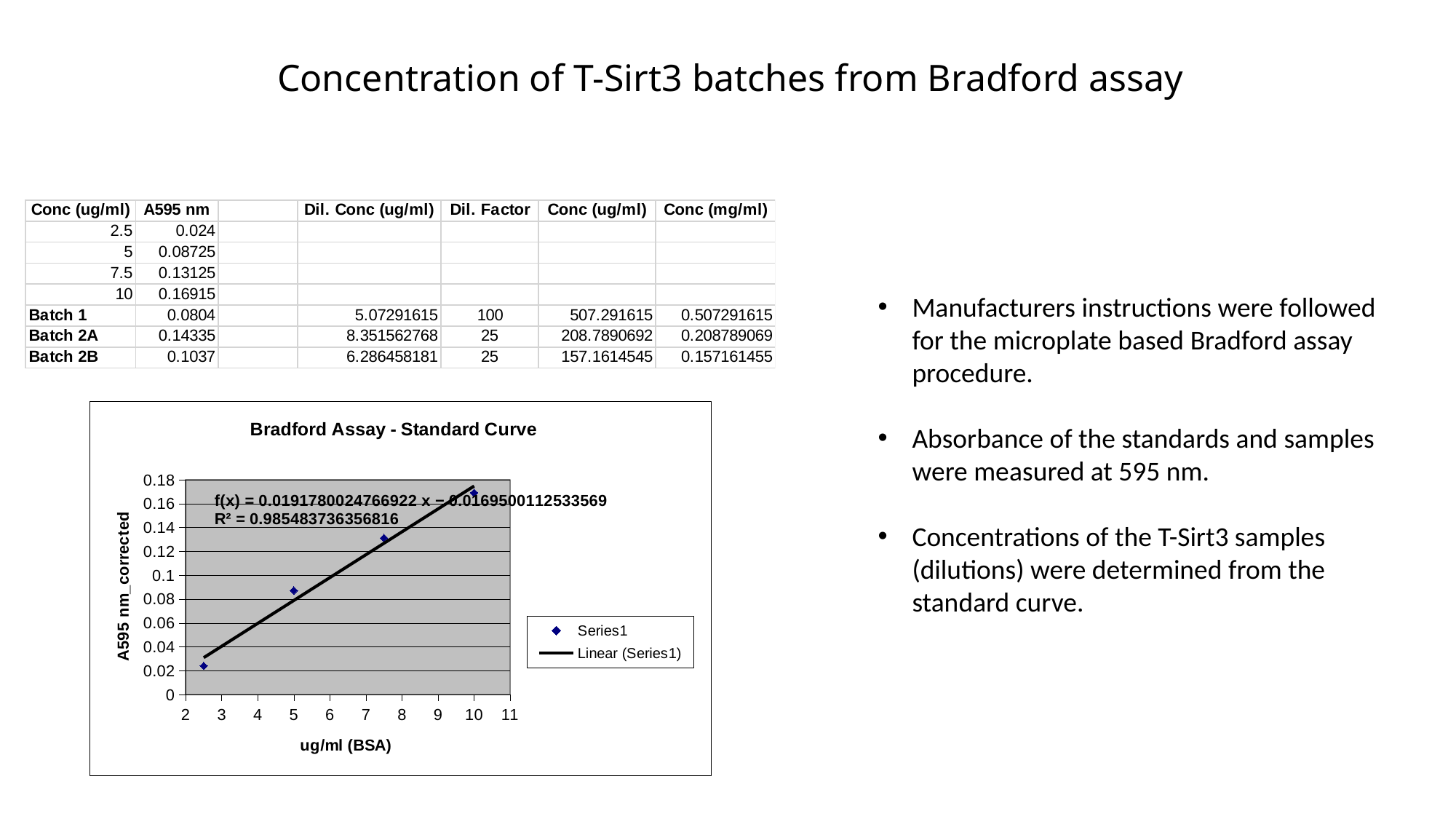
How many entries does the legend of the Bradford Assay - Standard Curve chart list? 2 Do the plotted values in the Bradford Assay - Standard Curve chart rise or fall as ug/ml (BSA) increases? rise In the Bradford Assay - Standard Curve chart, is the plotted value at 7.5 ug/ml (BSA) greater or less than 0.12? greater In the Bradford Assay - Standard Curve chart, is the plotted value at 10 ug/ml (BSA) greater or less than 0.16? greater What is the title of the chart on the slide? Bradford Assay - Standard Curve At which ug/ml (BSA) value is the plotted A595 nm_corrected highest in the Bradford Assay - Standard Curve chart? 10 What R² value is printed on the Bradford Assay - Standard Curve chart? 0.985483736356816 At which ug/ml (BSA) value is the plotted A595 nm_corrected lowest in the Bradford Assay - Standard Curve chart? 2.5 In the Bradford Assay - Standard Curve chart, which has the larger A595 nm_corrected value: the point at 5 ug/ml or the point at 7.5 ug/ml? 7.5 ug/ml How many data points are plotted in the Bradford Assay - Standard Curve chart? 4 What kind of chart is shown on the slide? scatter chart In the Bradford Assay - Standard Curve chart, is the plotted value at 5 ug/ml (BSA) greater or less than 0.1? less